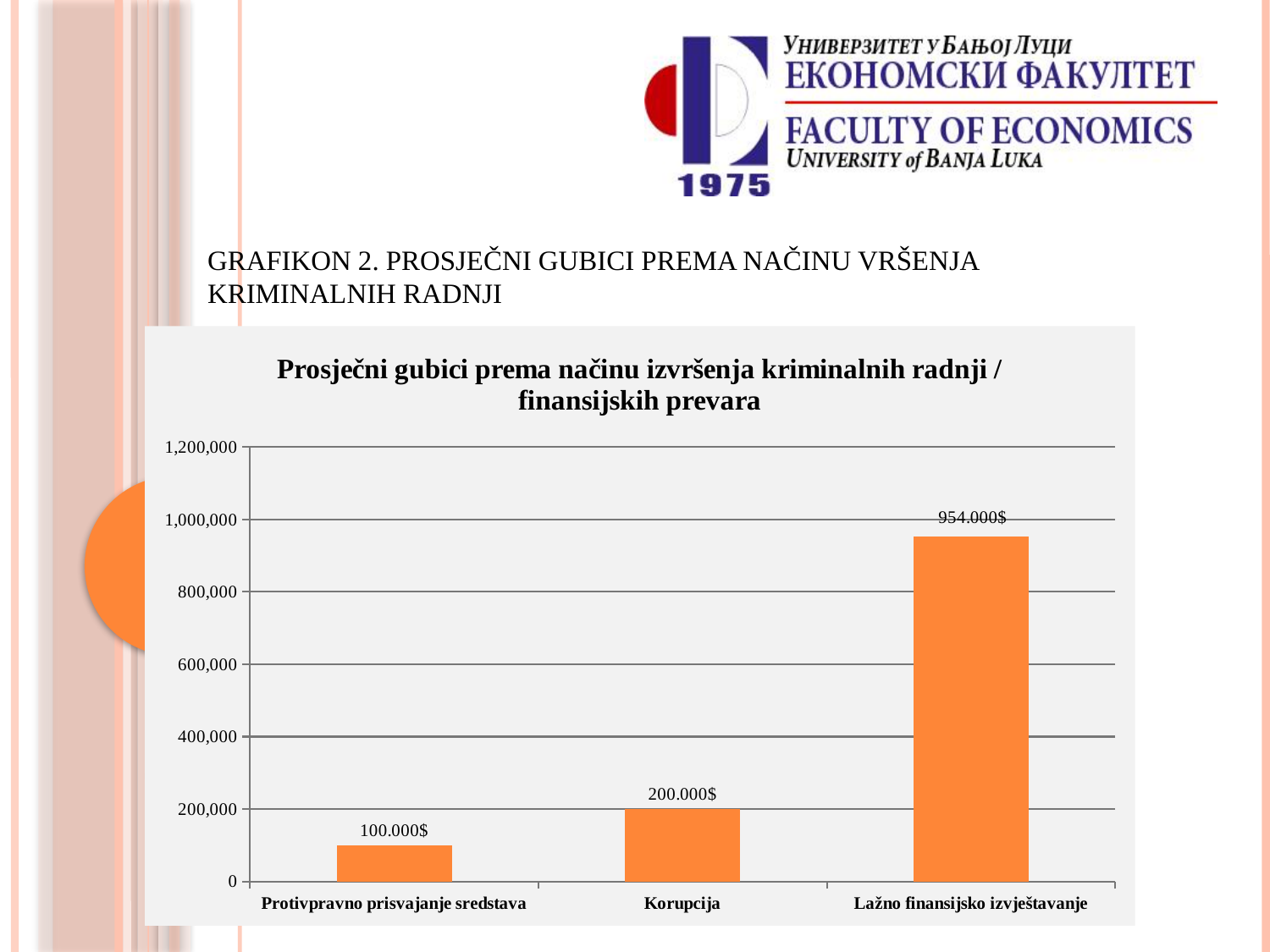
Which category has the highest average loss? Lažno finansijsko izvještavanje Is the value for Lažno finansijsko izvještavanje greater or less than 1,000,000? less What is the value for Lažno finansijsko izvještavanje? 954.000$ What is the title of the chart? Prosječni gubici prema načinu izvršenja kriminalnih radnji / finansijskih prevara What kind of chart is shown on the slide? bar chart What is the value for Protivpravno prisvajanje sredstava? 100.000$ How many categories are shown on the x axis? 3 Which is larger, the value for Korupcija or the value for Protivpravno prisvajanje sredstava? Korupcija What is the value for Korupcija? 200.000$ Which category has the lowest average loss? Protivpravno prisvajanje sredstava What is the difference between the values for Lažno finansijsko izvještavanje and Korupcija? 754.000$ What is the difference between the values for Korupcija and Protivpravno prisvajanje sredstava? 100.000$